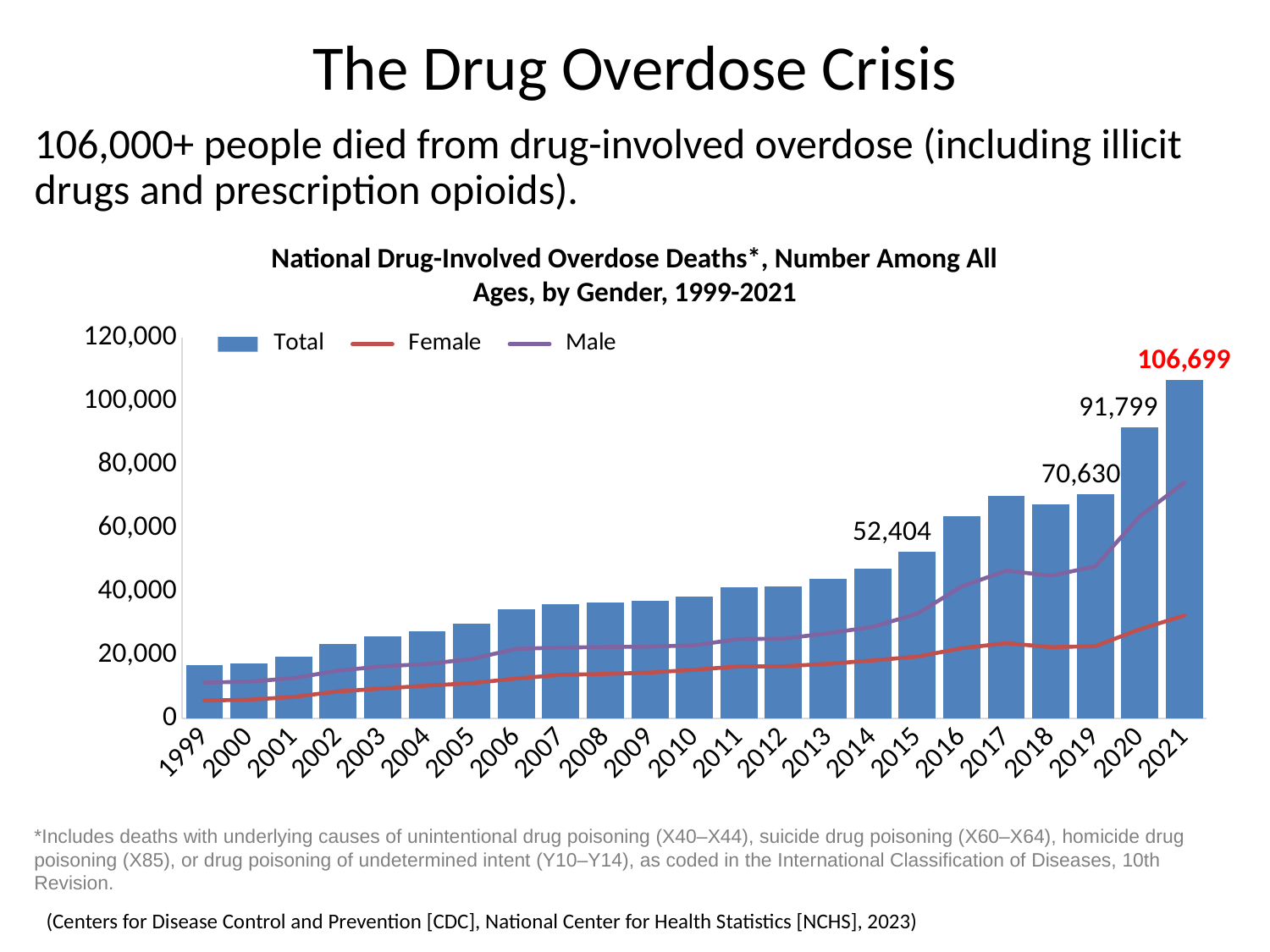
What is the total number of drug-involved overdose deaths shown for 2021? 106,699 Which year has the highest total number of overdose deaths? 2021 Is the total number of overdose deaths in 2016 greater or less than 60,000? greater What is the total number of drug-involved overdose deaths shown for 2020? 91,799 Which year has the lowest total number of overdose deaths? 1999 In 2021, which line is higher, Male or Female? Male By how much did the total number of overdose deaths increase from 2020 to 2021? 14,900 What is the total number of drug-involved overdose deaths shown for 2019? 70,630 How many years are shown on the x axis of the chart? 23 By how much did the total number of overdose deaths increase from 2019 to 2020? 21,169 What is the total number of drug-involved overdose deaths shown for 2015? 52,404 How many series does the chart legend list? 3